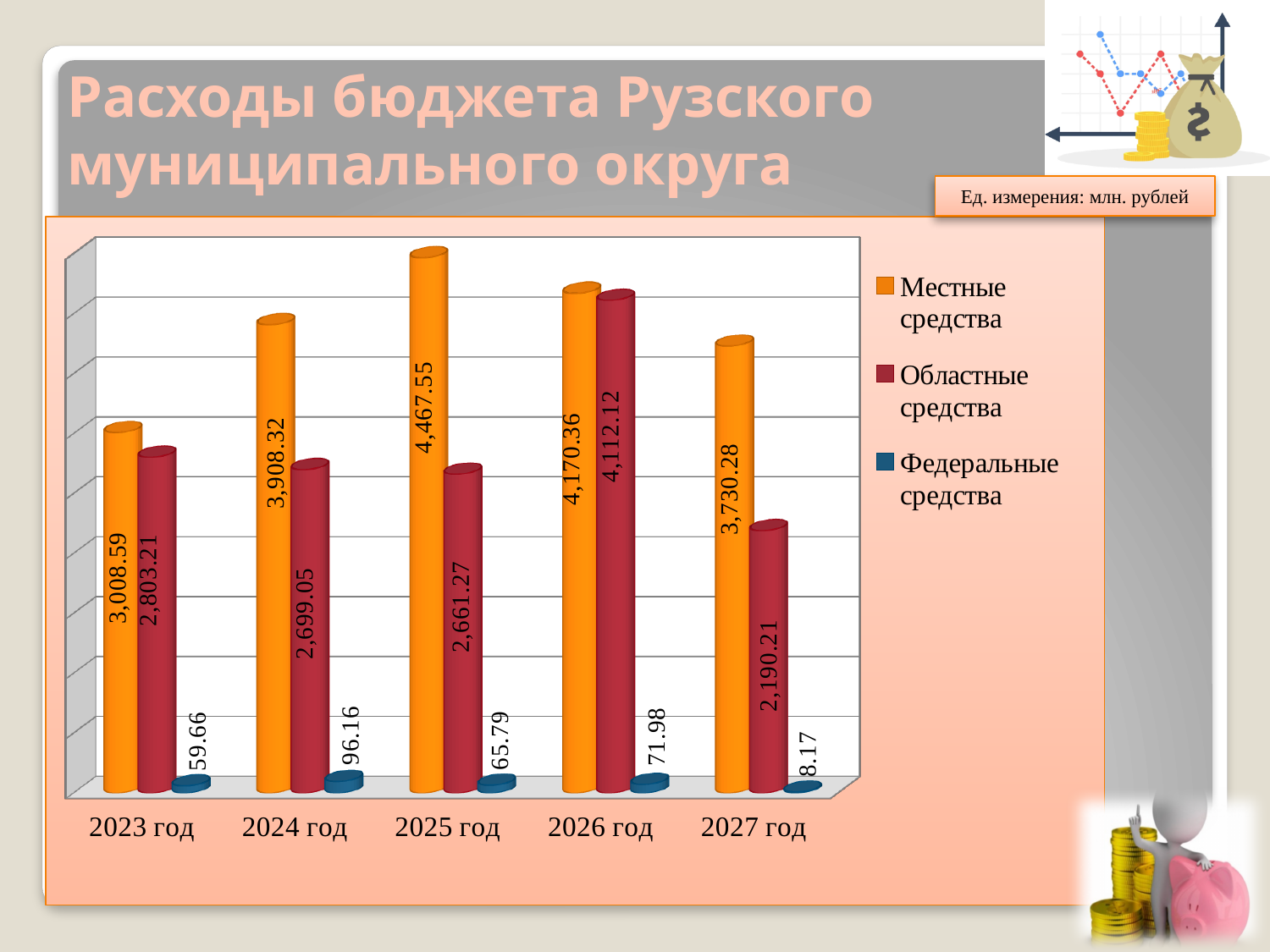
What is the difference between Местные средства and Областные средства in 2023 год? 205.38 What kind of chart is shown on the slide? Bar chart What unit of measurement is stated on the slide for the chart values? млн. рублей How many years are shown on the x axis? 5 How many series does the legend list? 3 In which year is the value for Областные средства the lowest? 2027 год In which year is the value for Федеральные средства the lowest? 2027 год What is the value for Федеральные средства in 2027 год? 8.17 What is the value for Областные средства in 2026 год? 4,112.12 In which year is the value for Местные средства the highest? 2025 год What is the value for Местные средства in 2025 год? 4,467.55 Which is larger in 2024 год: Местные средства or Областные средства? Местные средства